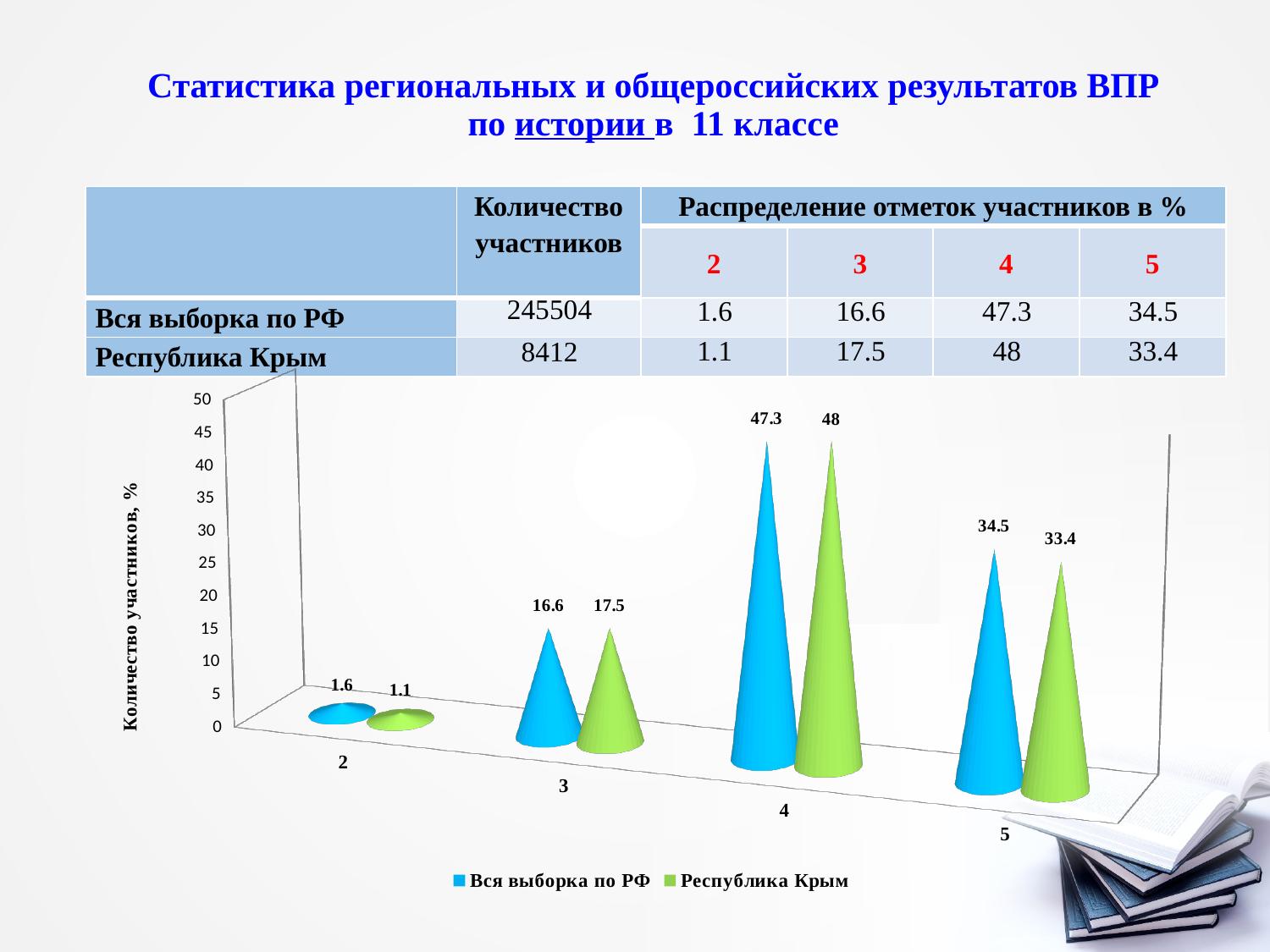
Which colour represents "Республика Крым" in the chart? green At mark 2, which series has the larger value: "Вся выборка по РФ" or "Республика Крым"? Вся выборка по РФ For which mark is the value for "Вся выборка по РФ" the highest? 4 What value does the chart show for "Республика Крым" at mark 3? 17.5 For which mark is the value for "Республика Крым" the lowest? 2 What kind of chart is shown on the slide? bar chart What value does the chart show for "Республика Крым" at mark 5? 33.4 How many marks (categories) are shown on the x axis of the chart? 4 What is the difference between the "Вся выборка по РФ" and "Республика Крым" values at mark 5? 1.1 How many series does the chart legend list? 2 What is the difference between the "Республика Крым" and "Вся выборка по РФ" values at mark 3? 0.9 What value does the chart show for "Вся выборка по РФ" at mark 4? 47.3